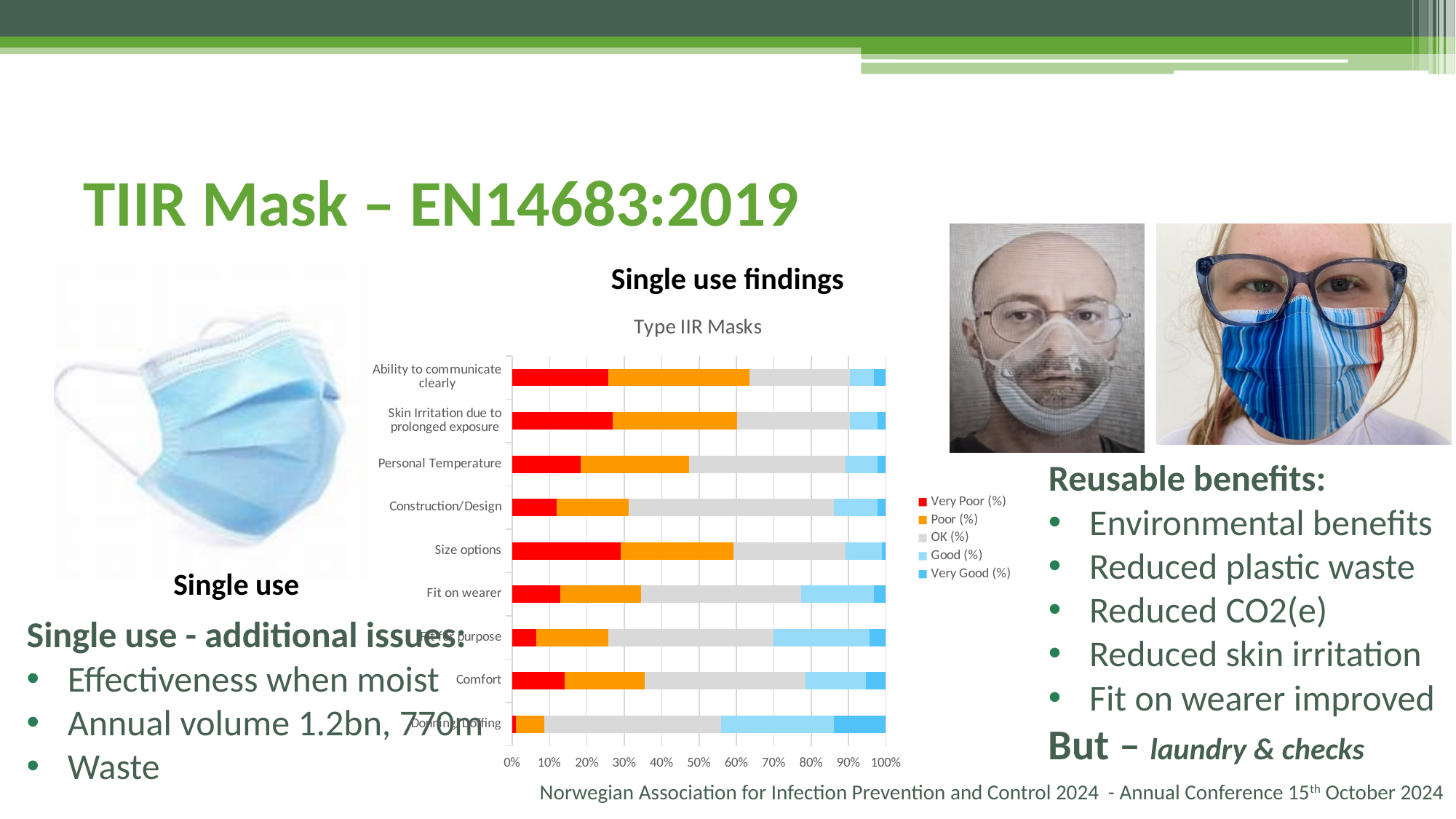
Is the 'Very Poor (%)' value for Construction/Design greater or less than 20%? less Which colour represents 'Very Poor (%)' in the chart legend? Red Which has the larger 'Good (%)' share: Fit on wearer or Ability to communicate clearly? Fit on wearer Is the 'Very Poor (%)' value for Ability to communicate clearly greater or less than 20%? greater What is the maximum value shown on the chart's horizontal axis? 100% Which has the larger 'Very Poor (%)' share: Size options or Construction/Design? Size options Is the 'Very Poor (%)' value for Size options greater or less than 20%? greater How many series does the chart's legend list? 5 What kind of chart is shown under the heading 'Single use findings'? Stacked bar chart Which has the larger 'OK (%)' share: Construction/Design or Size options? Construction/Design How many categories (bars) are plotted in the Type IIR Masks chart? 9 What is the title of the chart on the slide? Type IIR Masks